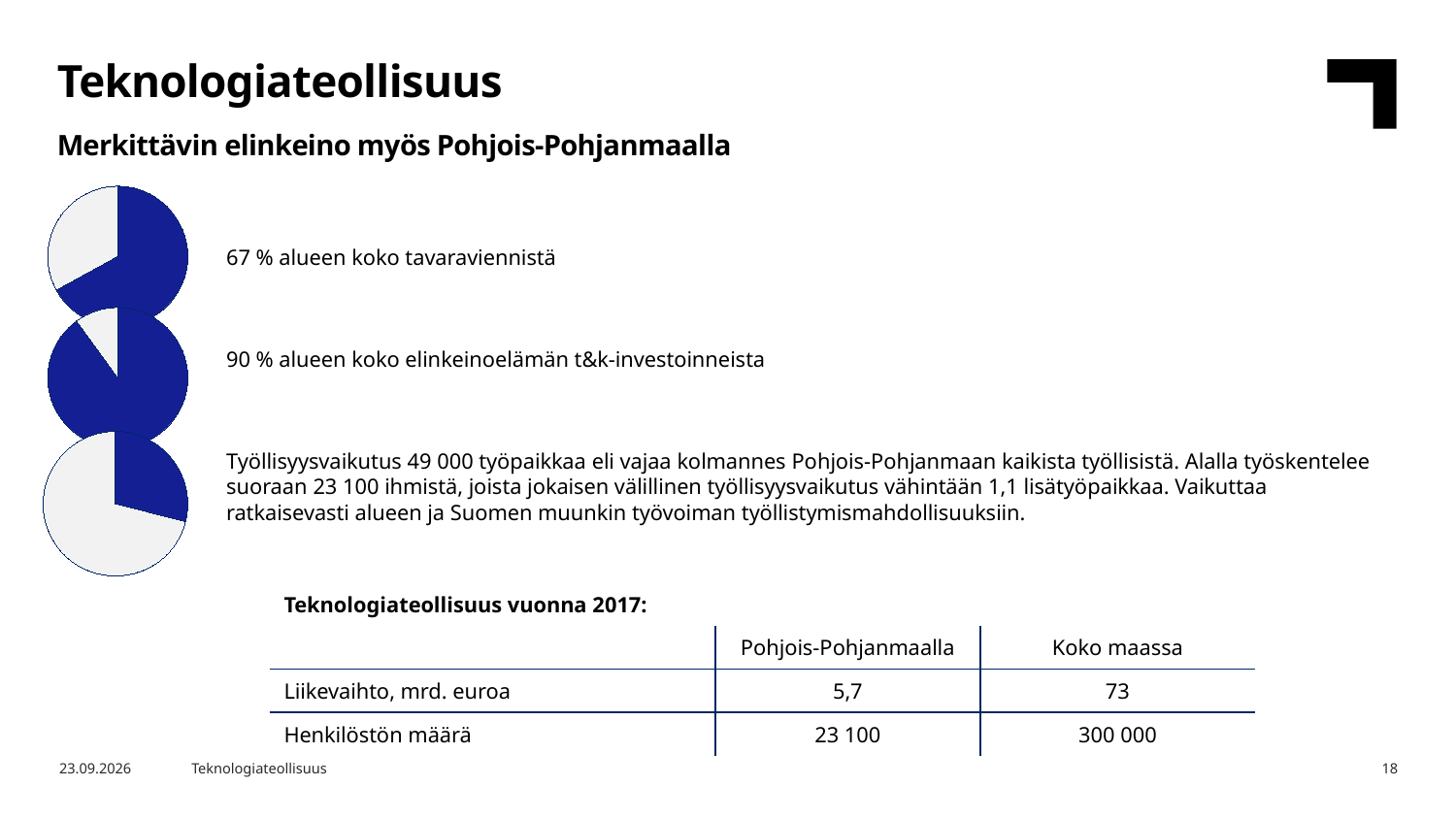
According to the text next to it, what does the middle pie chart's blue slice represent? alueen koko elinkeinoelämän t&k-investoinneista Which pie chart has the larger blue slice, the top one or the middle one? the middle one What kind of chart is the top chart on the left side of the slide? pie chart Of the three pie charts, which one has the largest blue slice? the middle one What colour is the highlighted slice in each of the pie charts? blue In the top pie chart, is the blue slice larger or smaller than the grey slice? larger In the top pie chart, what share does the blue slice represent according to the text beside it? 67 % In the bottom pie chart, is the blue slice larger or smaller than the grey slice? smaller In the middle pie chart, what share does the blue slice represent according to the text beside it? 90 % How many pie charts are shown on the slide? 3 How many slices does the top pie chart have? 2 Of the three pie charts, which one has the smallest blue slice? the bottom one